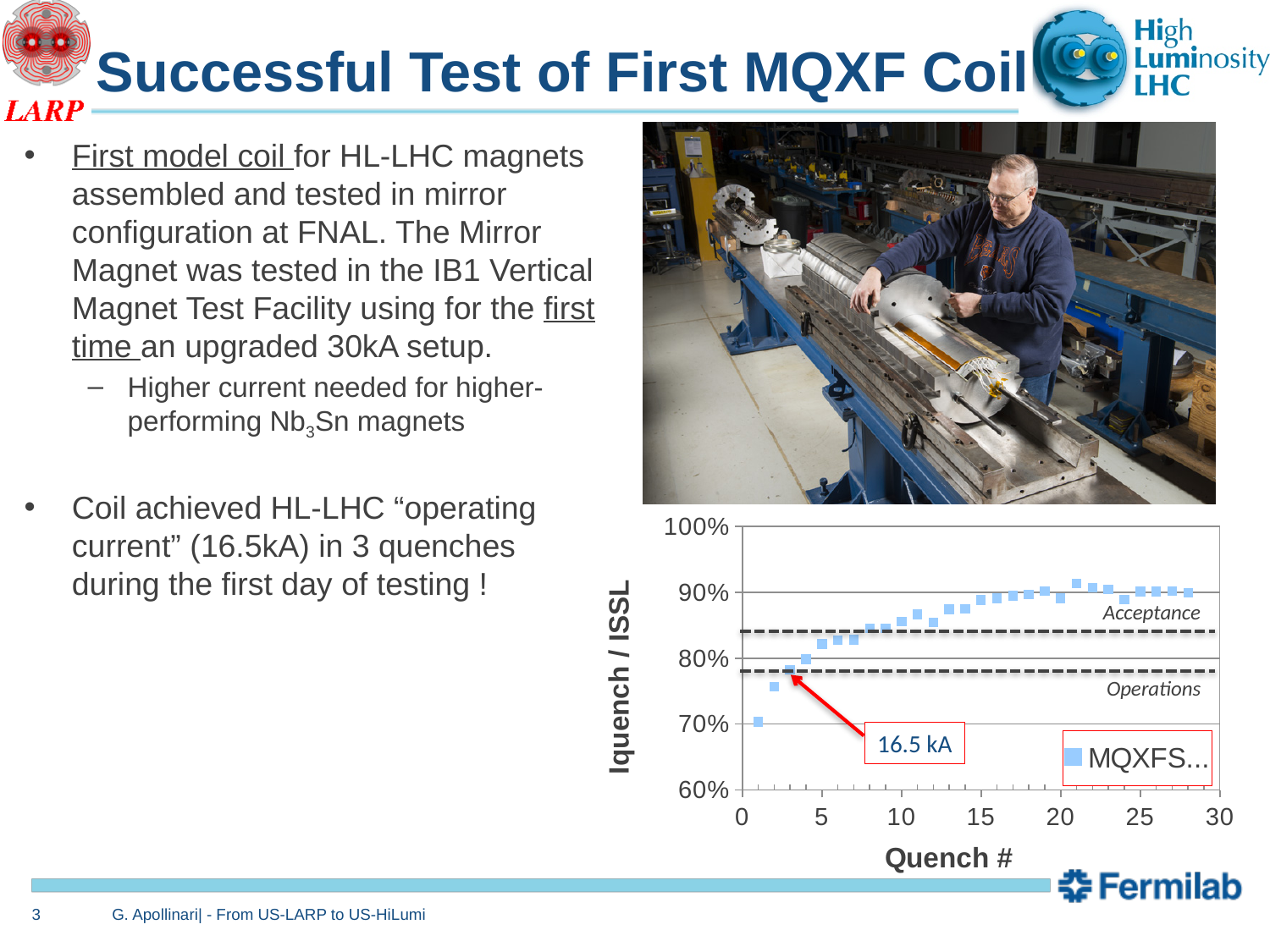
Is the Iquench / ISSL value at quench #25 greater or less than 100%? less Is the Iquench / ISSL value at quench #10 greater or less than 80%? greater How many series does the chart legend list? 1 What is the title of the x axis of the chart? Quench # Which has the larger Iquench / ISSL value, quench #1 or quench #10? quench #10 What kind of chart is shown on the slide? scatter chart Which has the larger Iquench / ISSL value, quench #5 or quench #15? quench #15 Which quench number has the lowest Iquench / ISSL value? 1 Is the Iquench / ISSL value at quench #2 greater or less than 80%? less Do the Iquench / ISSL values generally rise or fall as the quench number increases? rise What are the labels of the two dashed horizontal lines on the chart? Acceptance and Operations